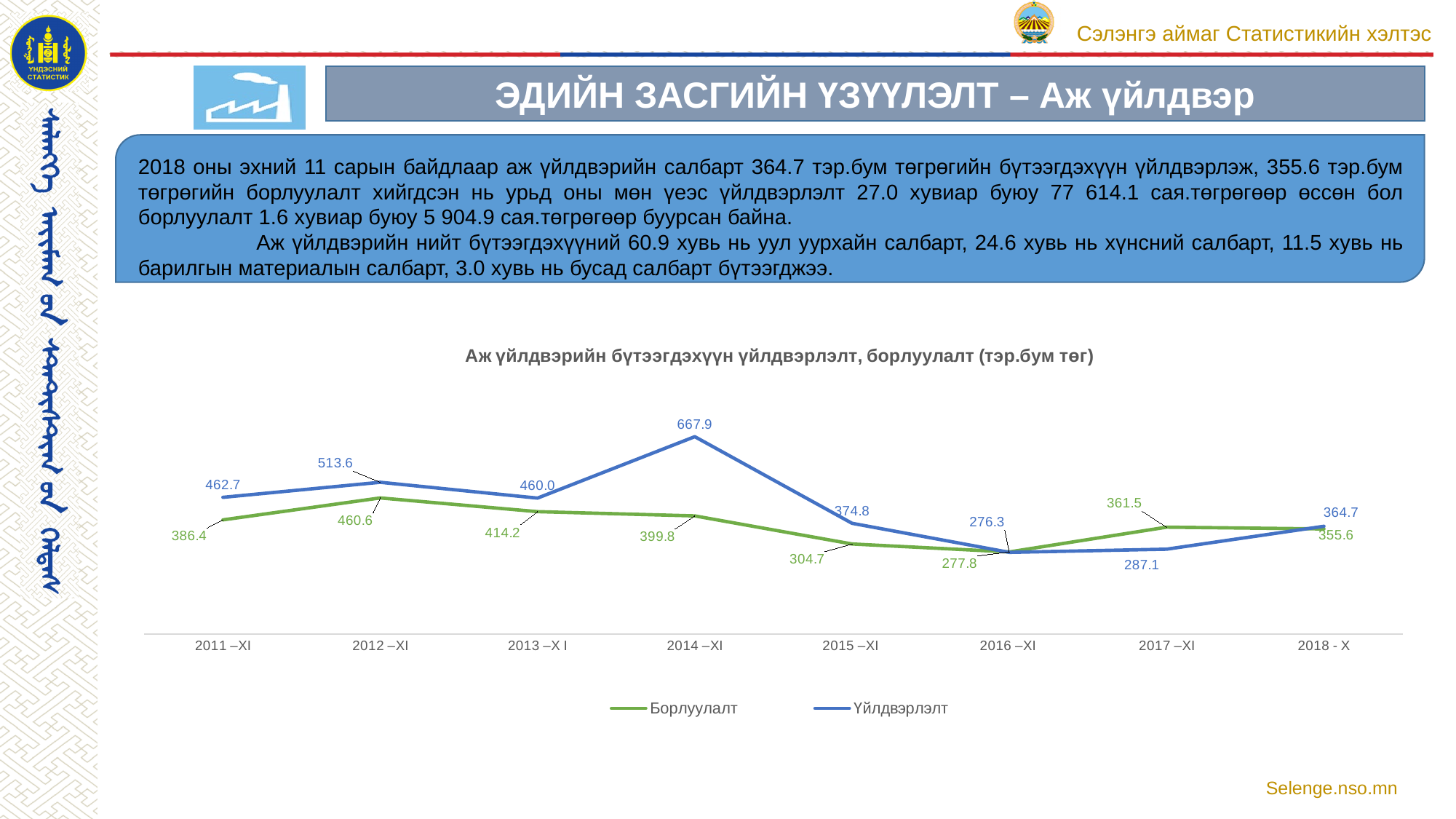
In which period is Үйлдвэрлэлт highest? 2014 –XI Does Үйлдвэрлэлт rise or fall from 2014 –XI to 2016 –XI? fall What is the value of Үйлдвэрлэлт for 2014 –XI? 667.9 How many series does the legend list? 2 What is the value of Борлуулалт for 2011 –XI? 386.4 What is the value of Үйлдвэрлэлт for 2018 - X? 364.7 In which period is Борлуулалт lowest? 2016 –XI What type of chart is shown on the slide? line chart What colour is the Борлуулалт line? green How many time points are plotted along the x axis? 8 Which is larger in 2017 –XI, Борлуулалт or Үйлдвэрлэлт? Борлуулалт What is the difference between Үйлдвэрлэлт and Борлуулалт in 2014 –XI? 268.1